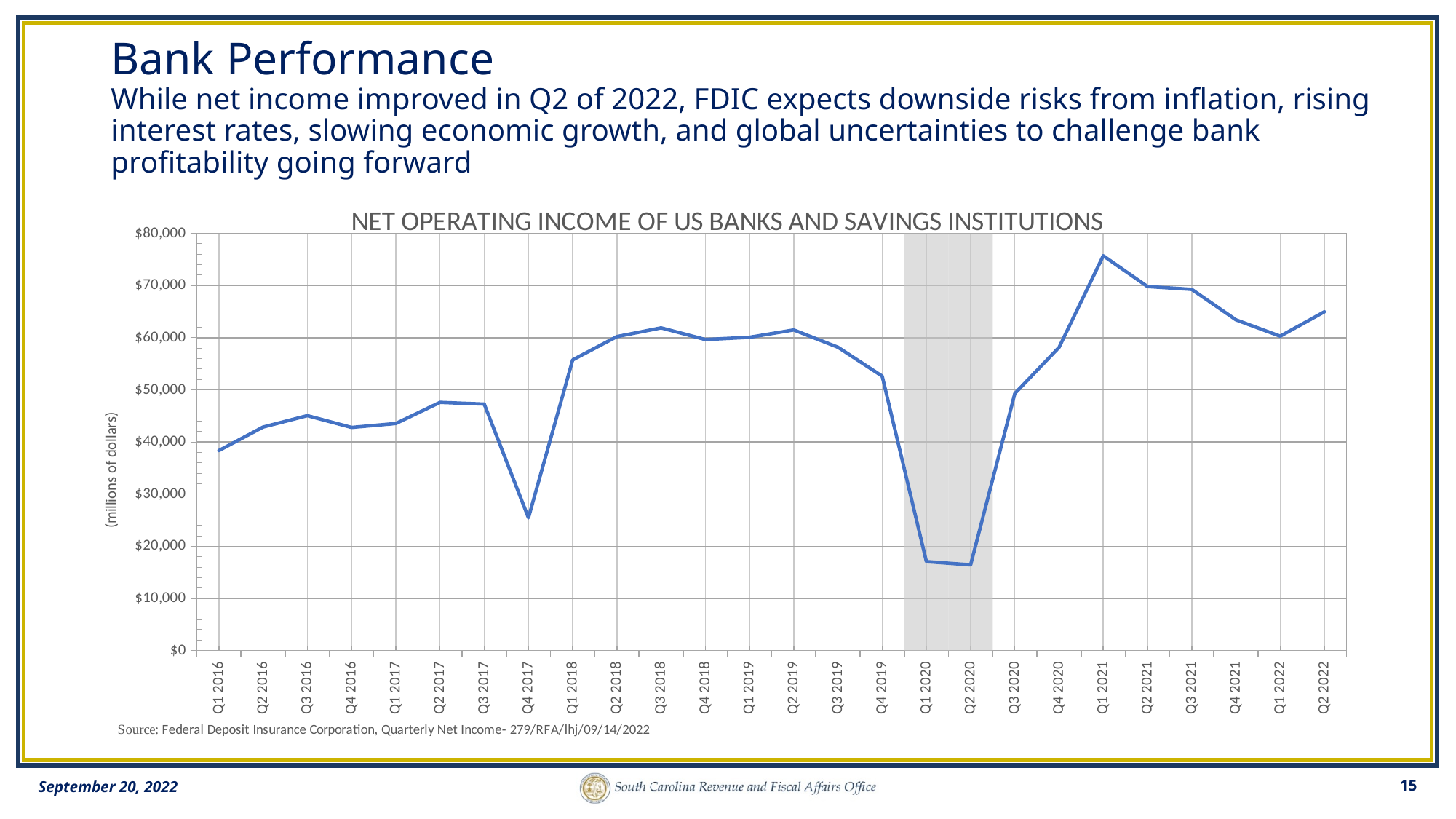
How many quarters are plotted on the x axis of the chart? 26 Is the value for Q1 2016 greater or less than $40,000? less Is the value for Q4 2017 greater or less than $30,000? less Is the value for Q1 2021 greater or less than $70,000? greater What kind of chart is shown on the slide? line chart Which quarter has the highest net operating income on the chart? Q1 2021 What unit is given on the vertical axis of the chart? millions of dollars What is the title of the chart? NET OPERATING INCOME OF US BANKS AND SAVINGS INSTITUTIONS Which is larger, the value for Q4 2017 or the value for Q1 2018? Q1 2018 Does net operating income rise or fall from Q4 2019 to Q2 2020? fall